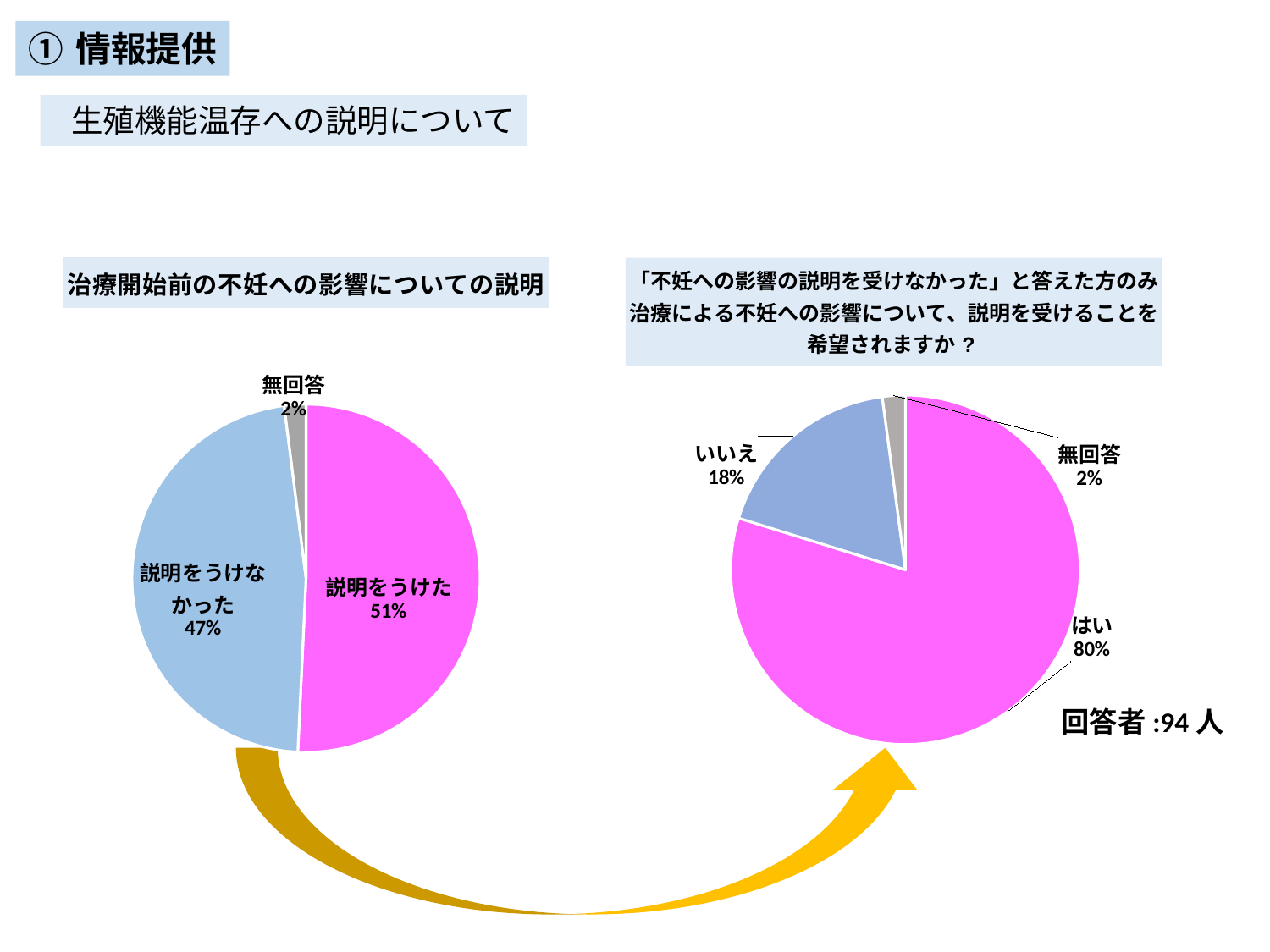
In the right pie chart (説明を受けることを希望されますか？), what share is labelled for いいえ? 18% In the right pie chart (説明を受けることを希望されますか？), what is the difference between はい and いいえ? 62% How many respondents (回答者) are stated next to the right pie chart? 94 人 In the left pie chart (治療開始前の不妊への影響についての説明), how many slices are there? 3 In the left pie chart (治療開始前の不妊への影響についての説明), what is the difference between 説明をうけた and 説明をうけなかった? 4% In the right pie chart (説明を受けることを希望されますか？), what share is labelled for はい? 80% In the left pie chart (治療開始前の不妊への影響についての説明), what share is labelled for 説明をうけた? 51% In the left pie chart (治療開始前の不妊への影響についての説明), which slice is the smallest? 無回答 In the right pie chart (説明を受けることを希望されますか？), which slice is the largest? はい In the left pie chart (治療開始前の不妊への影響についての説明), what share is labelled for 説明をうけなかった? 47% In the right pie chart (説明を受けることを希望されますか？), which is larger, はい or いいえ? はい What kind of chart is used on the left of the slide? Pie chart